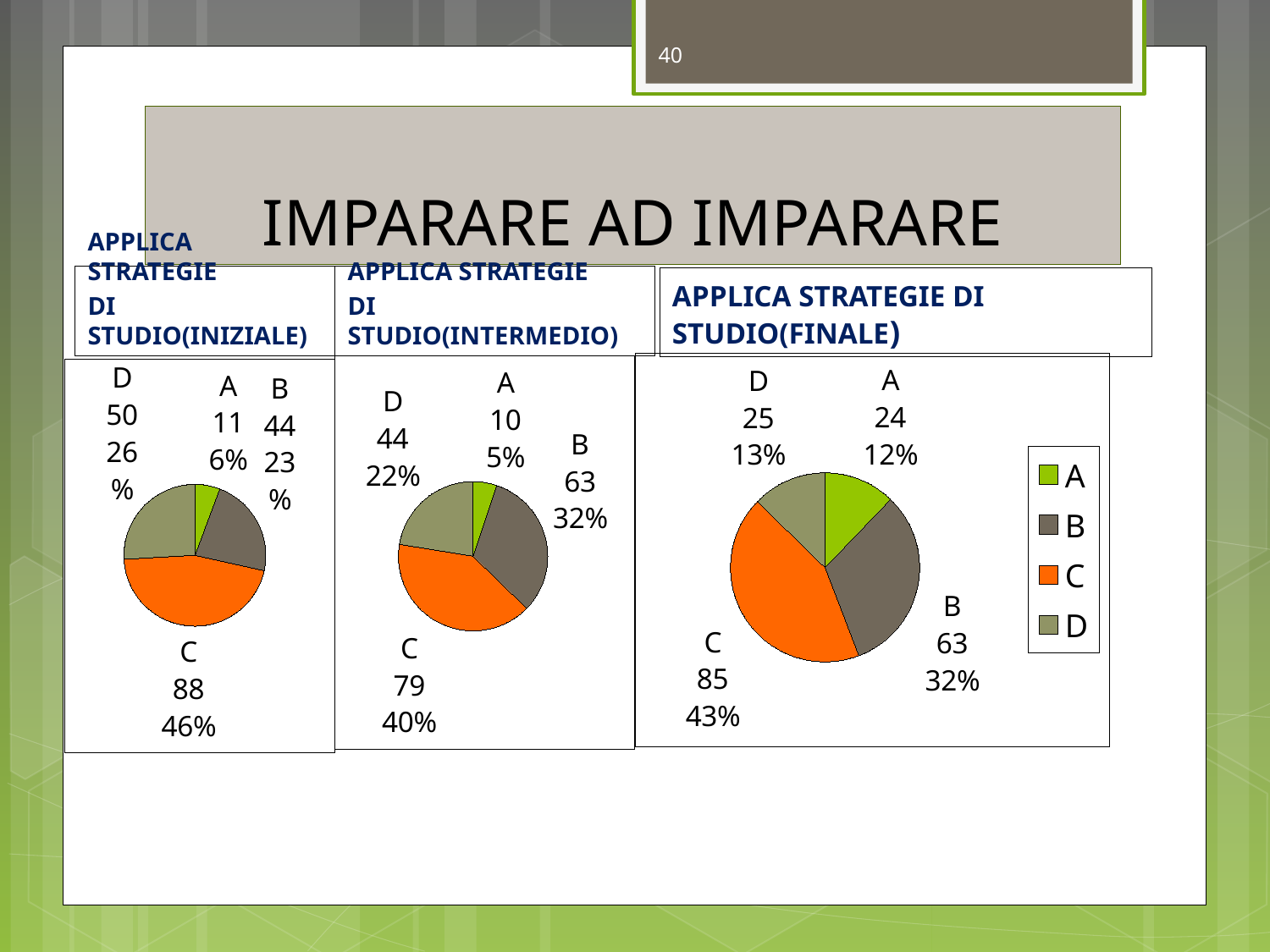
What type of chart is used for APPLICA STRATEGIE DI STUDIO(FINALE)? Pie chart In the APPLICA STRATEGIE DI STUDIO(INTERMEDIO) pie chart, what percentage share does C have? 40% In the APPLICA STRATEGIE DI STUDIO(INTERMEDIO) pie chart, what is the value for B? 63 In the APPLICA STRATEGIE DI STUDIO(FINALE) pie chart, what is the value for A? 24 According to the legend, which colour represents category C? Orange In the APPLICA STRATEGIE DI STUDIO(FINALE) pie chart, what is the difference between the values for C and B? 22 In the APPLICA STRATEGIE DI STUDIO(INTERMEDIO) pie chart, which category has the largest slice? C In the APPLICA STRATEGIE DI STUDIO(INIZIALE) pie chart, what is the value for C? 88 How many categories does the legend on the right of the slide list? 4 In the APPLICA STRATEGIE DI STUDIO(INIZIALE) pie chart, what percentage share does D have? 26% In the APPLICA STRATEGIE DI STUDIO(FINALE) pie chart, which is larger, the value for D or the value for A? D In the APPLICA STRATEGIE DI STUDIO(INIZIALE) pie chart, which category has the smallest slice? A